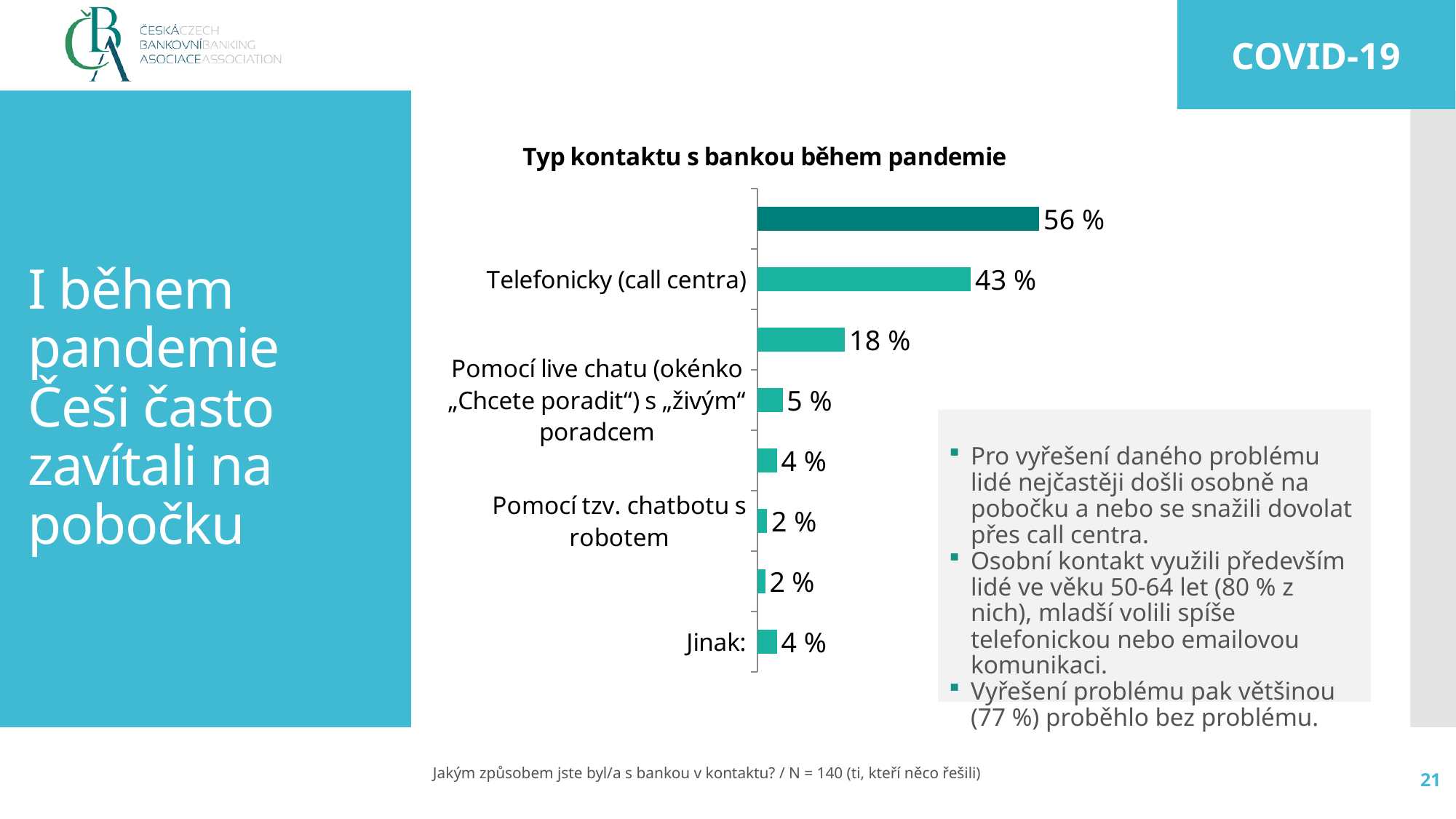
What type of chart is shown on the slide? bar chart Which is larger: the value for Jinak: or the value for Pomocí tzv. chatbotu s robotem? Jinak: What is the value for Pomocí live chatu (okénko „Chcete poradit“) s „živým“ poradcem? 5 % What is the value for Pomocí tzv. chatbotu s robotem? 2 % What is the title of the chart? Typ kontaktu s bankou během pandemie What is the highest value shown in the chart? 56 % What is the value for Telefonicky (call centra)? 43 % How many bars are plotted in the chart? 8 What is the lowest value shown in the chart? 2 % What is the difference between the value for Telefonicky (call centra) and the value for Pomocí live chatu (okénko „Chcete poradit“) s „živým“ poradcem? 38 % What is the value for Jinak:? 4 % What is the difference between the highest value in the chart and the value for Telefonicky (call centra)? 13 %